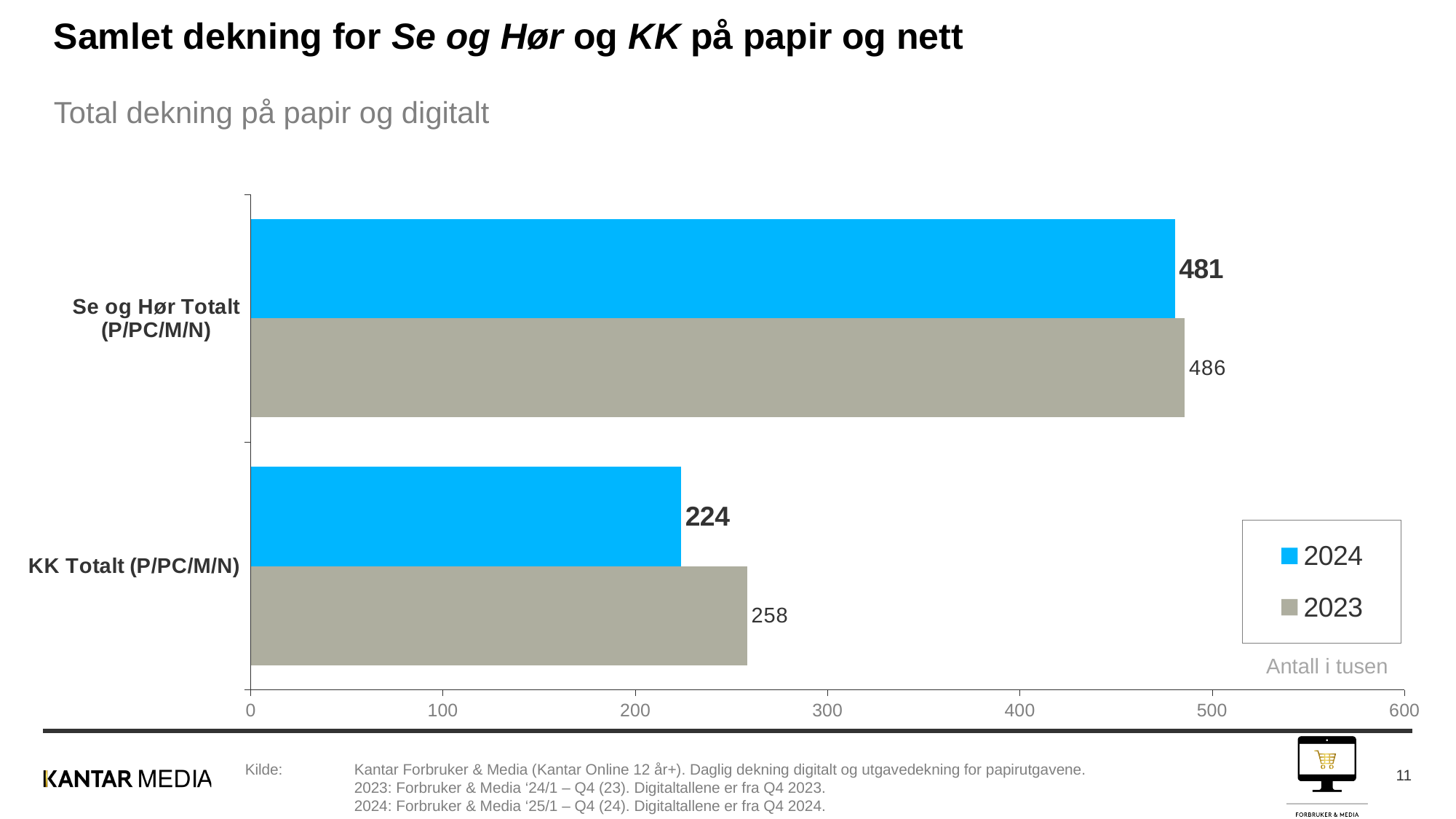
What is the 2024 value for Se og Hør Totalt (P/PC/M/N)? 481 What is the 2024 value for KK Totalt (P/PC/M/N)? 224 How many series does the legend list? 2 What is the 2023 value for Se og Hør Totalt (P/PC/M/N)? 486 Which category has the highest 2024 value? Se og Hør Totalt (P/PC/M/N) What is the 2023 value for KK Totalt (P/PC/M/N)? 258 What is the difference between the 2023 and 2024 values for Se og Hør Totalt (P/PC/M/N)? 5 What is the difference between the 2023 and 2024 values for KK Totalt (P/PC/M/N)? 34 Which category has the lowest 2023 value? KK Totalt (P/PC/M/N) How many categories are shown on the chart? 2 Is the 2024 value for KK Totalt (P/PC/M/N) larger or smaller than its 2023 value? smaller What kind of chart is shown on the slide? bar chart